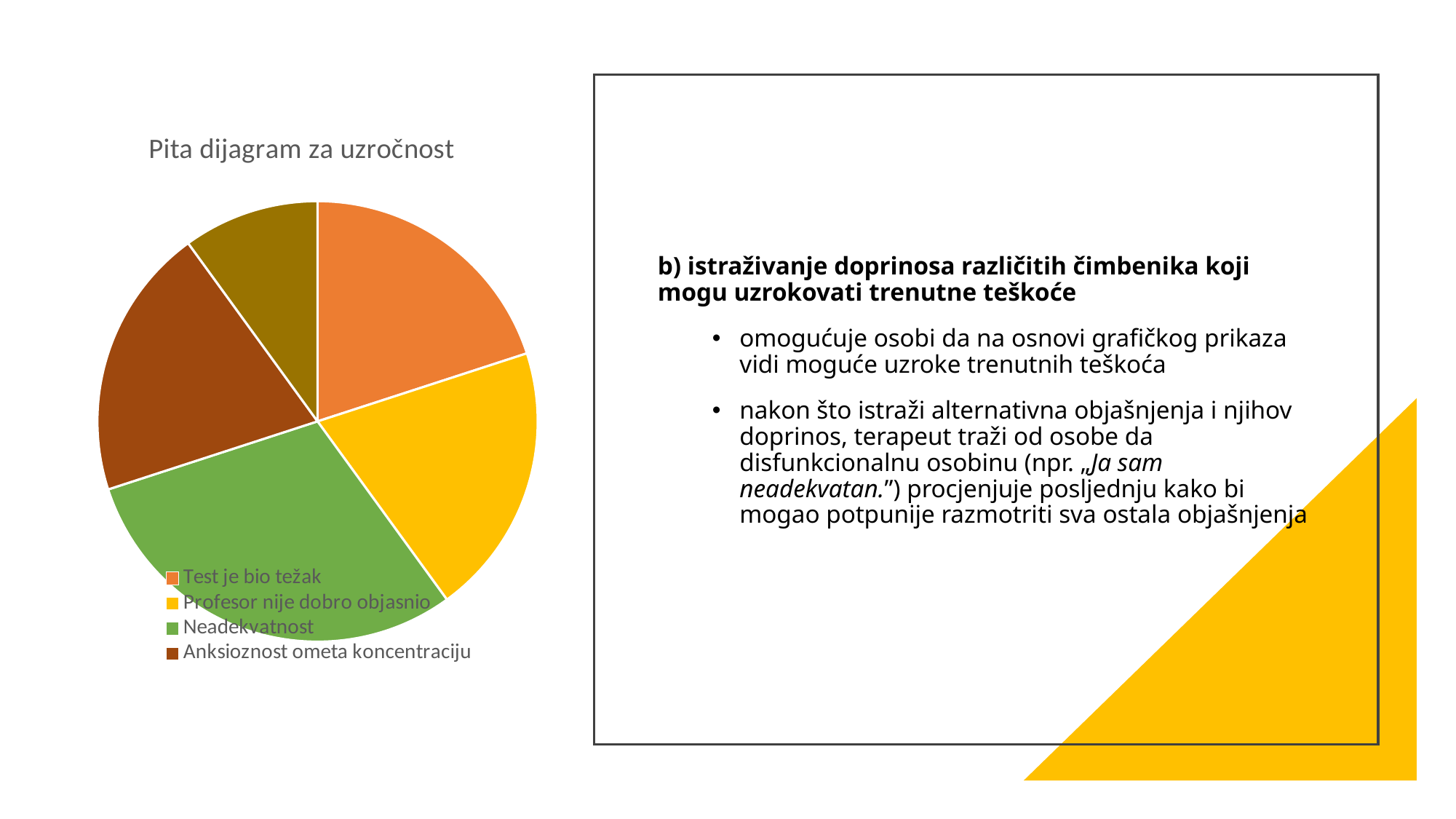
Which slice is larger, Neadekvatnost or Anksioznost ometa koncentraciju? Neadekvatnost What colour is the slice for Neadekvatnost in the pie chart? green What is the title of the chart on the slide? Pita dijagram za uzročnost How many entries does the chart's legend list? 4 Which slice is larger, Neadekvatnost or Profesor nije dobro objasnio? Neadekvatnost What kind of chart is shown on the slide? pie chart Which labelled category has the largest slice of the pie? Neadekvatnost Which slice is larger, Neadekvatnost or Test je bio težak? Neadekvatnost How many slices does the pie chart have? 5